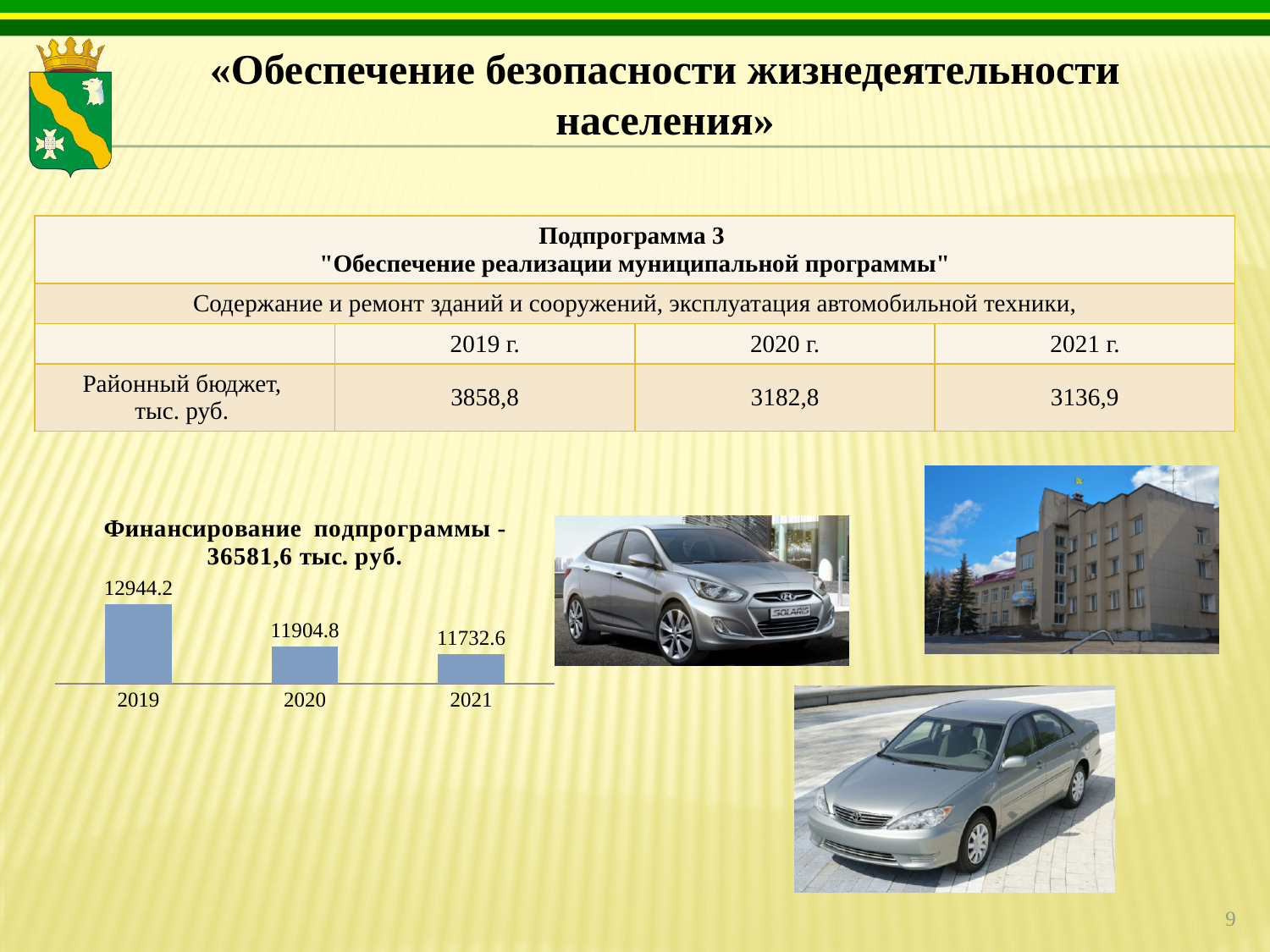
What is the value for 2019 in the bar chart? 12944.2 What is the title of the bar chart? Финансирование подпрограммы - 36581,6 тыс. руб. What kind of chart is shown on the slide? bar chart What is the difference between the 2019 and 2020 values in the bar chart? 1039.4 Do the values in the bar chart rise or fall from 2019 to 2021? fall What is the value for 2021 in the bar chart? 11732.6 How many years are shown in the bar chart? 3 What is the value for 2020 in the bar chart? 11904.8 Which year has the lowest value in the bar chart? 2021 Which year has the highest value in the bar chart? 2019 Which is larger in the bar chart, the value for 2019 or the value for 2021? 2019 What is the difference between the 2020 and 2021 values in the bar chart? 172.2